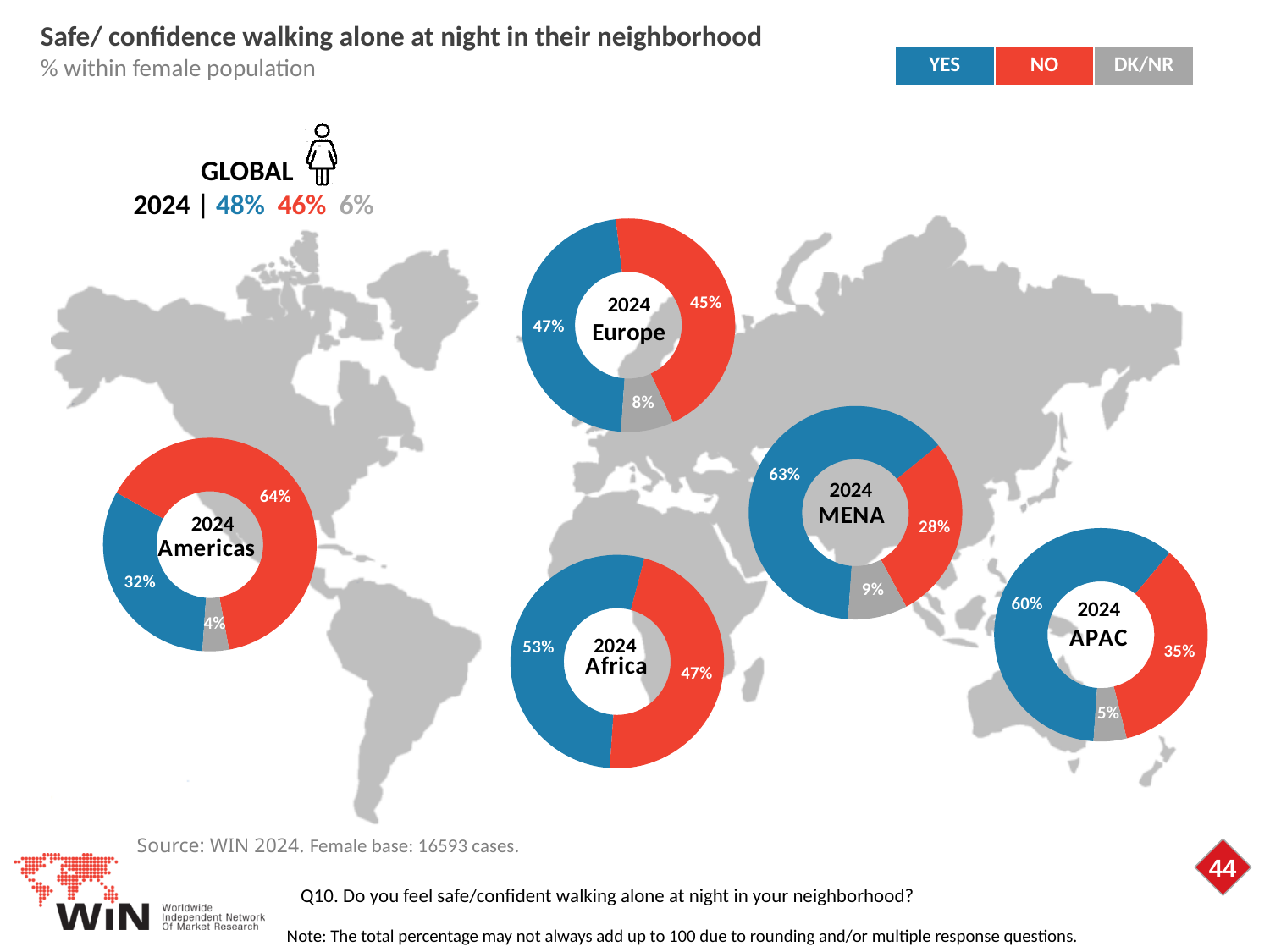
In the 2024 Americas donut chart, what percentage of women answered NO? 64% In the 2024 MENA donut chart, what percentage of women answered DK/NR? 9% Across the five regional donut charts, which region has the highest YES share? MENA Across the five regional donut charts, which region has the lowest YES share? Americas Is the YES share larger in the 2024 MENA chart or the 2024 APAC chart? MENA In the 2024 APAC donut chart, what percentage of women answered YES? 60% In the 2024 Africa donut chart, what percentage of women answered NO? 47% What type of chart is used to show each region's results on the slide? Donut (pie) chart In the 2024 Americas donut chart, what is the difference between the NO share and the YES share? 32% How many regional donut charts are shown on the slide? 5 In the 2024 Europe donut chart, what percentage of women answered YES? 47% Which colour represents the NO response in the legend? Red